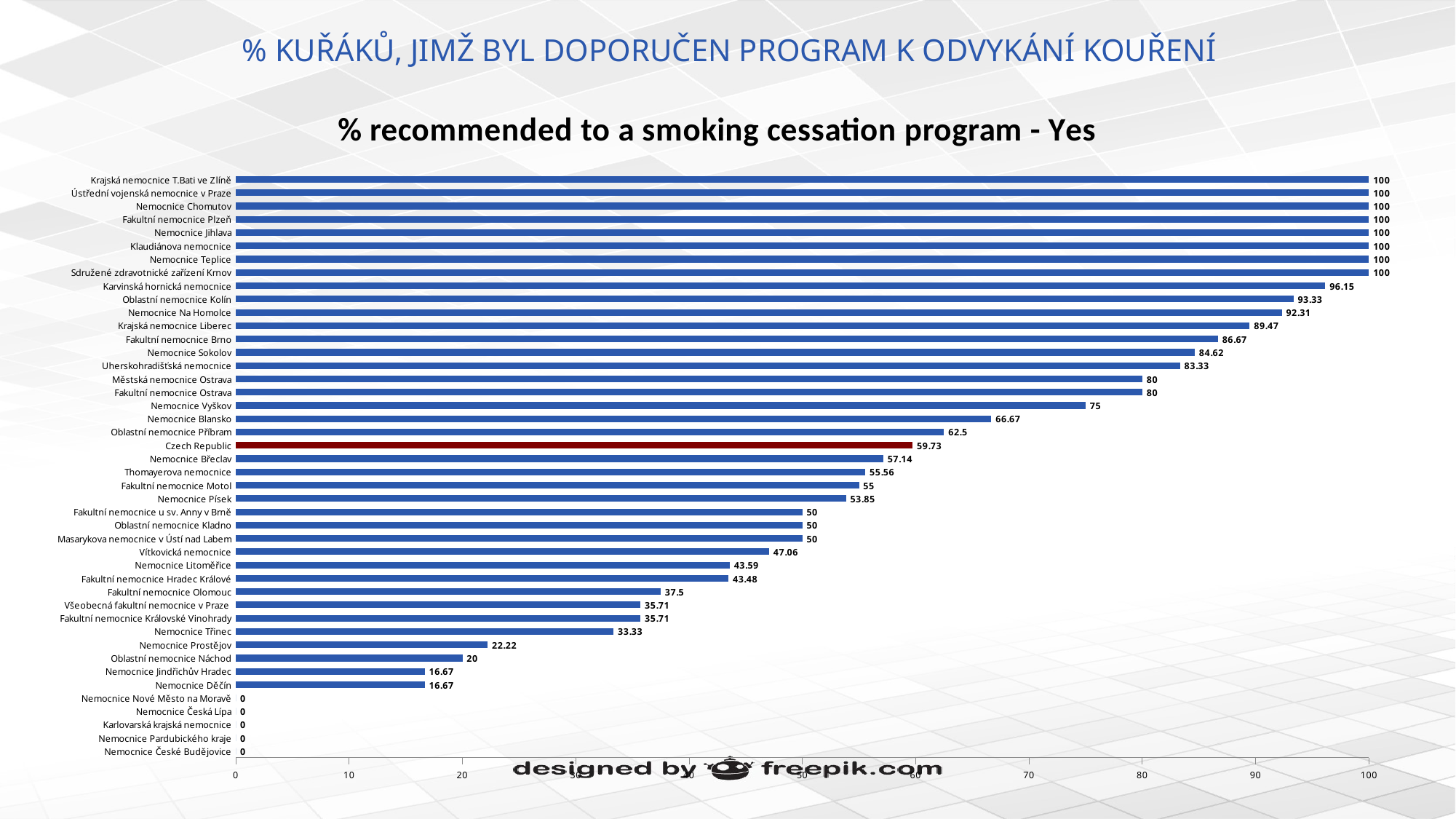
What kind of chart is shown on the slide? Bar chart What is the difference between the value for Czech Republic and the value for Nemocnice Břeclav? 2.59 How many categories have a value of 0? 5 Which bar is shown in a different colour (dark red) from the others? Czech Republic What is the value for Karvinská hornická nemocnice? 96.15 What is the value for Nemocnice Prostějov? 22.22 How many categories are plotted in the chart? 44 Which is larger, the value for Nemocnice Vyškov or the value for Nemocnice Blansko? Nemocnice Vyškov What is the difference between the values for Fakultní nemocnice Brno and Nemocnice Sokolov? 2.05 What is the value for Fakultní nemocnice Motol? 55 What is the value for Czech Republic? 59.73 How many hospitals have a value of 100? 8